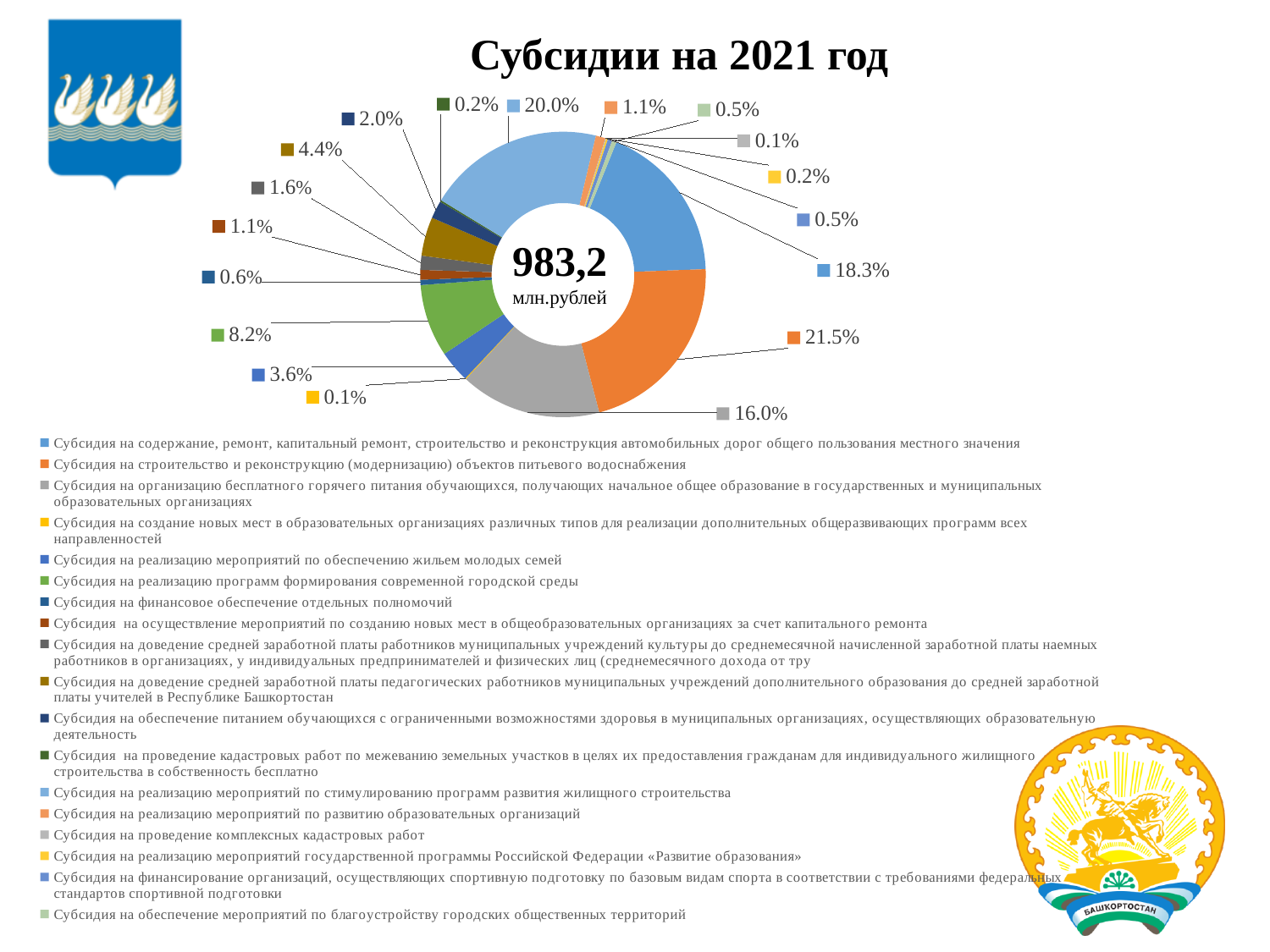
What total value is printed in the centre of the doughnut chart? 983,2 млн.рублей Which is larger: the 20.0% slice or the 18.3% slice? The 20.0% slice What share does the subsidy for roads (Субсидия на содержание, ремонт, капитальный ремонт, строительство и реконструкция автомобильных дорог) have? 18.3% Which subsidy has the largest share of the chart? Субсидия на строительство и реконструкцию (модернизацию) объектов питьевого водоснабжения What share does the subsidy for urban environment programmes (Субсидия на реализацию программ формирования современной городской среды) have? 8.2% What is the largest share shown on the chart? 21.5% What is the smallest share value shown on the chart? 0.1% What kind of chart is shown on the slide? Pie (doughnut) chart How many subsidy categories does the legend list? 18 What share does the subsidy for free hot meals for primary school pupils (Субсидия на организацию бесплатного горячего питания обучающихся) have? 16.0% What is the difference in percentage points between the 21.5% slice and the 16.0% slice? 5.5 percentage points What is the title of the chart? Субсидии на 2021 год